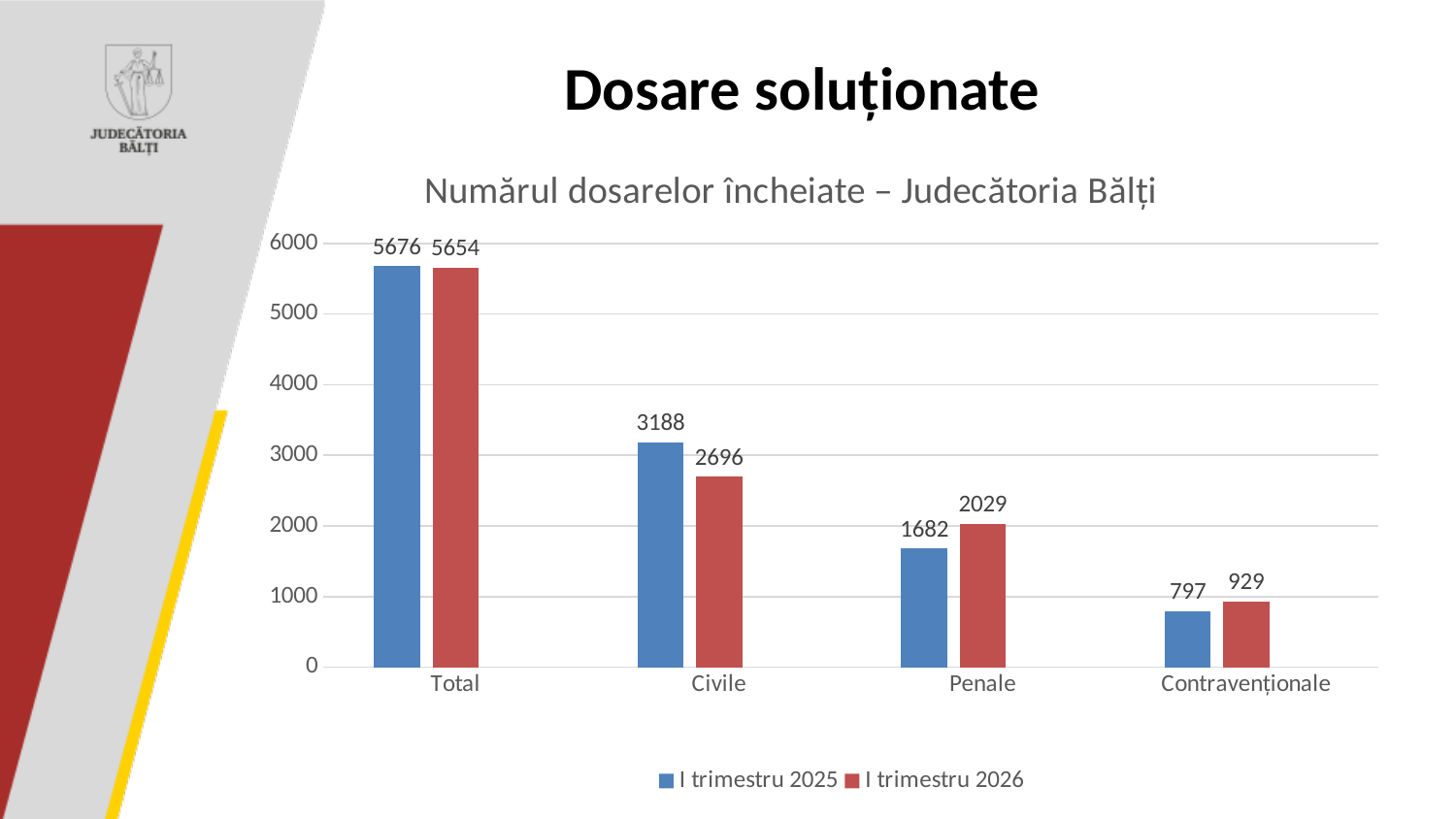
What type of chart is shown on the slide? Bar chart What is the Total value for I trimestru 2026? 5654 Which category has the lowest value in the I trimestru 2026 series? Contravenționale Excluding Total, which category has the highest value in the I trimestru 2025 series? Civile What is the difference between the I trimestru 2025 and I trimestru 2026 values for Civile? 492 What is the value for Penale in the I trimestru 2026 series? 2029 How many categories are shown on the x axis? 4 What is the difference between the I trimestru 2026 and I trimestru 2025 values for Penale? 347 How many series does the legend list? 2 What is the value for Civile in the I trimestru 2025 series? 3188 For Contravenționale, which series has the larger value, I trimestru 2025 or I trimestru 2026? I trimestru 2026 What is the value for Contravenționale in the I trimestru 2025 series? 797